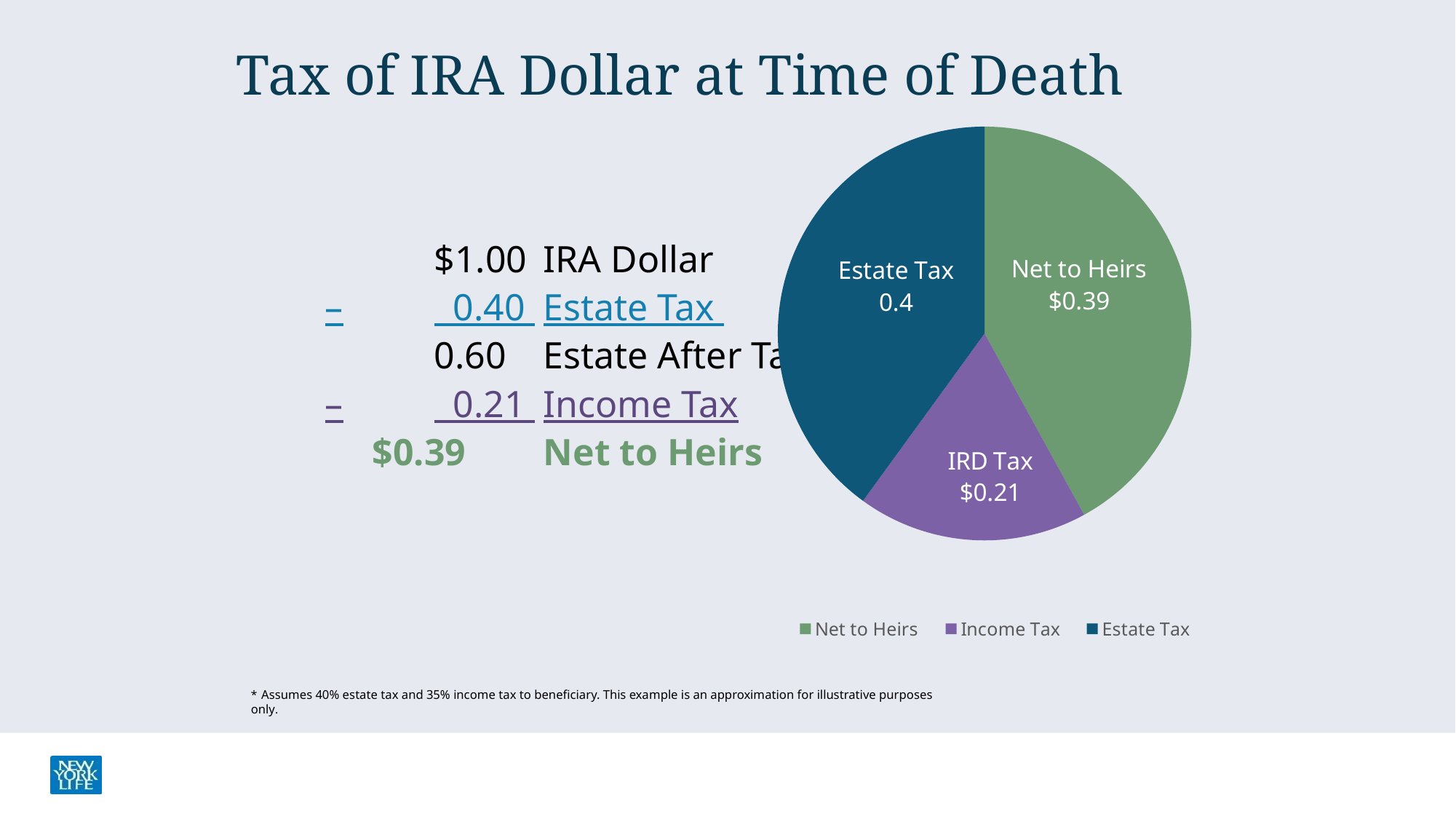
Which is larger in the pie chart, Estate Tax or IRD Tax? Estate Tax What is the value of the Estate Tax slice in the pie chart? 0.4 What is the difference between the Net to Heirs slice and the IRD Tax slice? $0.18 Which is larger in the pie chart, Net to Heirs or IRD Tax? Net to Heirs What is the value of the IRD Tax slice in the pie chart? $0.21 What is the value of the Net to Heirs slice in the pie chart? $0.39 What type of chart is shown on the slide? pie chart How many slices does the pie chart have? 3 How many entries does the pie chart's legend list? 3 Which slice of the pie chart is the smallest? IRD Tax What are the three entries listed in the pie chart's legend? Net to Heirs, Income Tax, Estate Tax